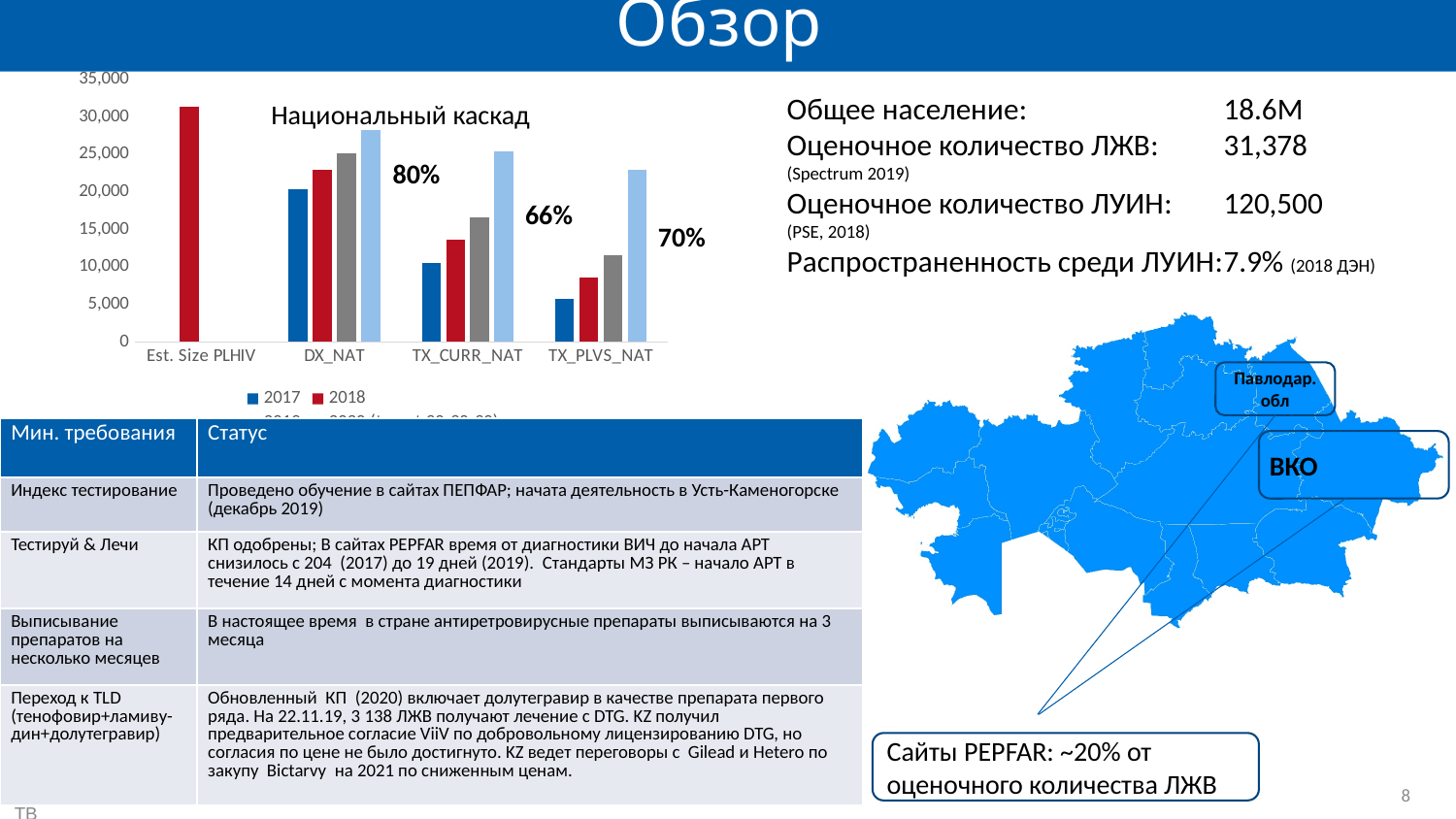
In the 'Национальный каскад' chart, is the 2018 value for DX_NAT greater or less than 20,000? greater In the 'Национальный каскад' chart, which category has the lowest 2017 value? TX_PLVS_NAT In the 'Национальный каскад' chart, which category has the tallest bar? Est. Size PLHIV In the 'Национальный каскад' chart, what percentage label is shown next to the TX_PLVS_NAT bars? 70% In the 'Национальный каскад' chart, which is larger for 2017: DX_NAT or TX_CURR_NAT? DX_NAT In the 'Национальный каскад' chart, do the 2017 values rise or fall from DX_NAT to TX_PLVS_NAT? fall What is the title of the bar chart on the slide? Национальный каскад How many categories are shown on the x axis of the 'Национальный каскад' chart? 4 In the 'Национальный каскад' chart, what percentage label is shown next to the DX_NAT bars? 80% In the 'Национальный каскад' chart, is the 2017 value for TX_PLVS_NAT greater or less than 10,000? less What kind of chart is the 'Национальный каскад' chart? bar chart In the 'Национальный каскад' chart, is the 2018 value for TX_CURR_NAT greater or less than 15,000? less